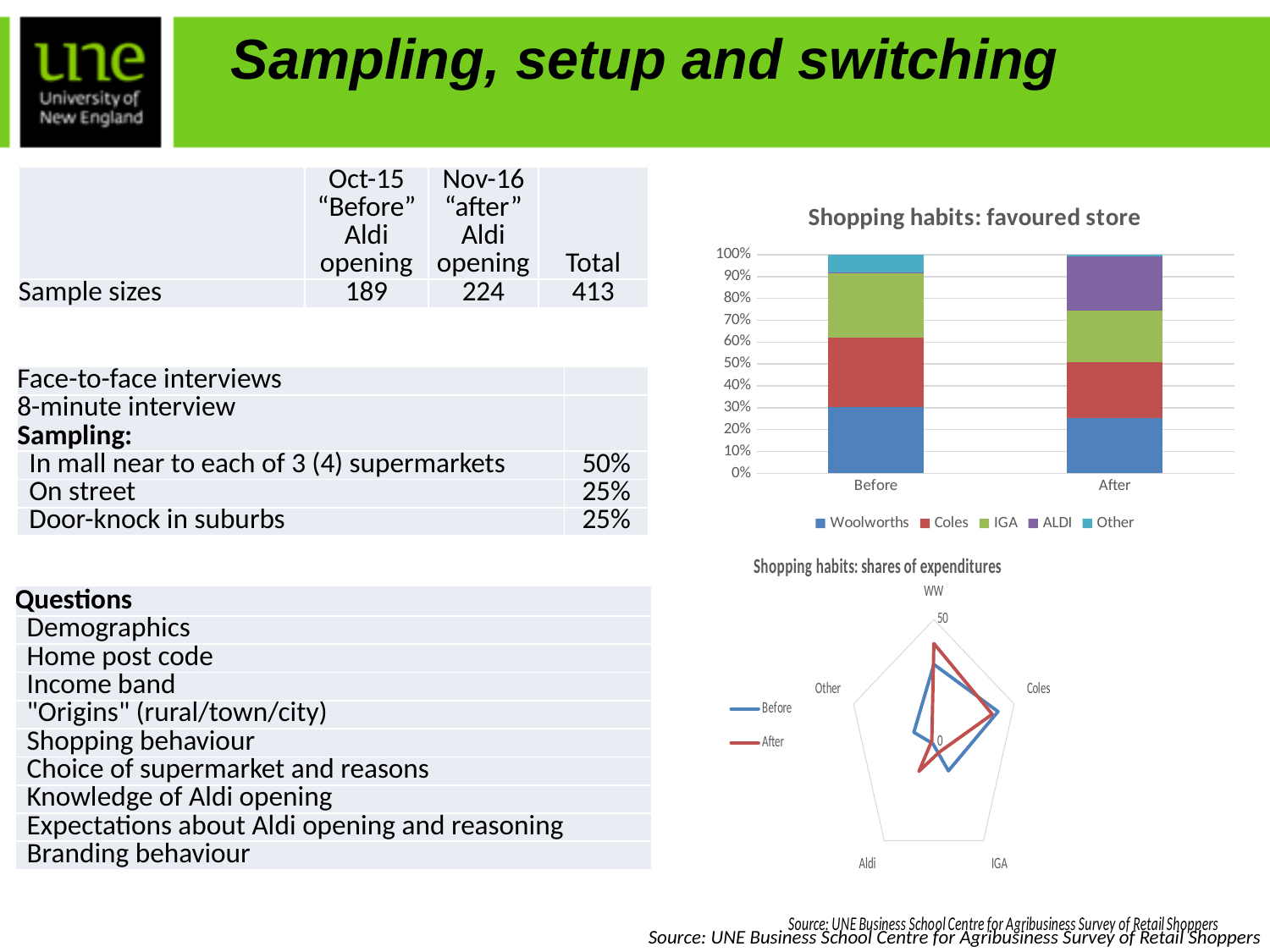
How many categories are shown on the x axis of "Shopping habits: favoured store"? 2 In "Shopping habits: favoured store", is the Woolworths share for Before greater or less than 20%? greater In "Shopping habits: favoured store", is the Coles share larger for Before or for After? Before Which stores are the axes of the radar chart "Shopping habits: shares of expenditures"? WW, Coles, IGA, Aldi, Other In "Shopping habits: favoured store", is the Woolworths share larger for Before or for After? Before In "Shopping habits: favoured store", is the ALDI share for After greater or less than 10%? greater What kind of chart is "Shopping habits: favoured store"? Stacked bar chart How many series does the legend of "Shopping habits: favoured store" list? 5 How many series does the legend of "Shopping habits: shares of expenditures" list? 2 In "Shopping habits: favoured store", does the Woolworths share rise or fall from Before to After? fall What kind of chart is "Shopping habits: shares of expenditures"? Radar chart In "Shopping habits: favoured store", is the Woolworths share for After greater or less than 30%? less